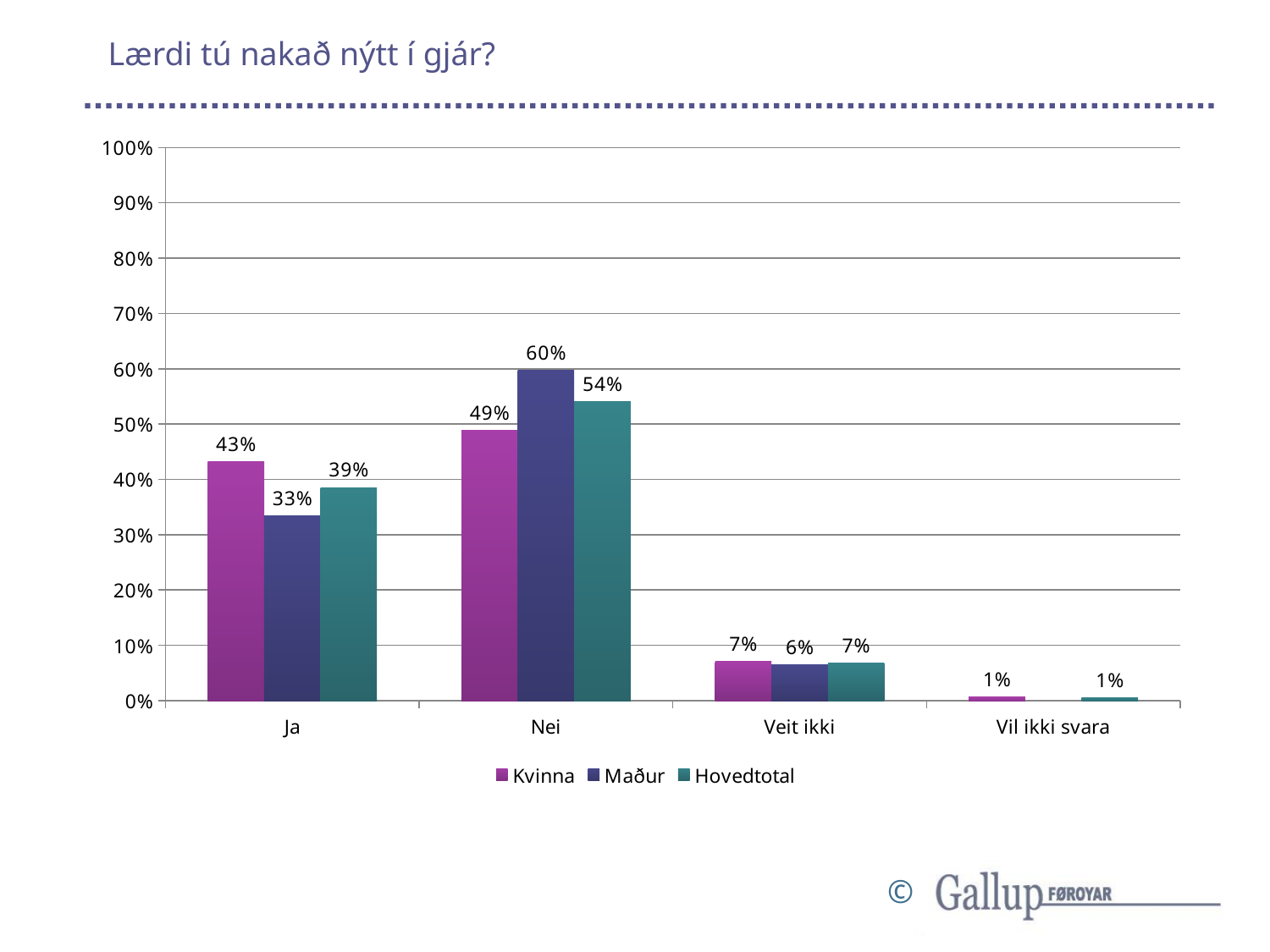
What kind of chart is shown on the slide? bar chart Which category has the highest Hovedtotal value? Nei Which is larger for Ja: the Kvinna value or the Maður value? Kvinna What is the Hovedtotal value for Veit ikki? 7% What is the value for Kvinna in the Ja category? 43% Which category has the lowest Kvinna value? Vil ikki svara What is the difference between the Maður and Kvinna values for Nei? 11% What is the title of the chart? Lærdi tú nakað nýtt í gjár? What is the value for Maður in the Nei category? 60% How many categories are shown on the x axis? 4 How many series does the legend list? 3 Is the Hovedtotal value for Nei greater or less than 50%? greater